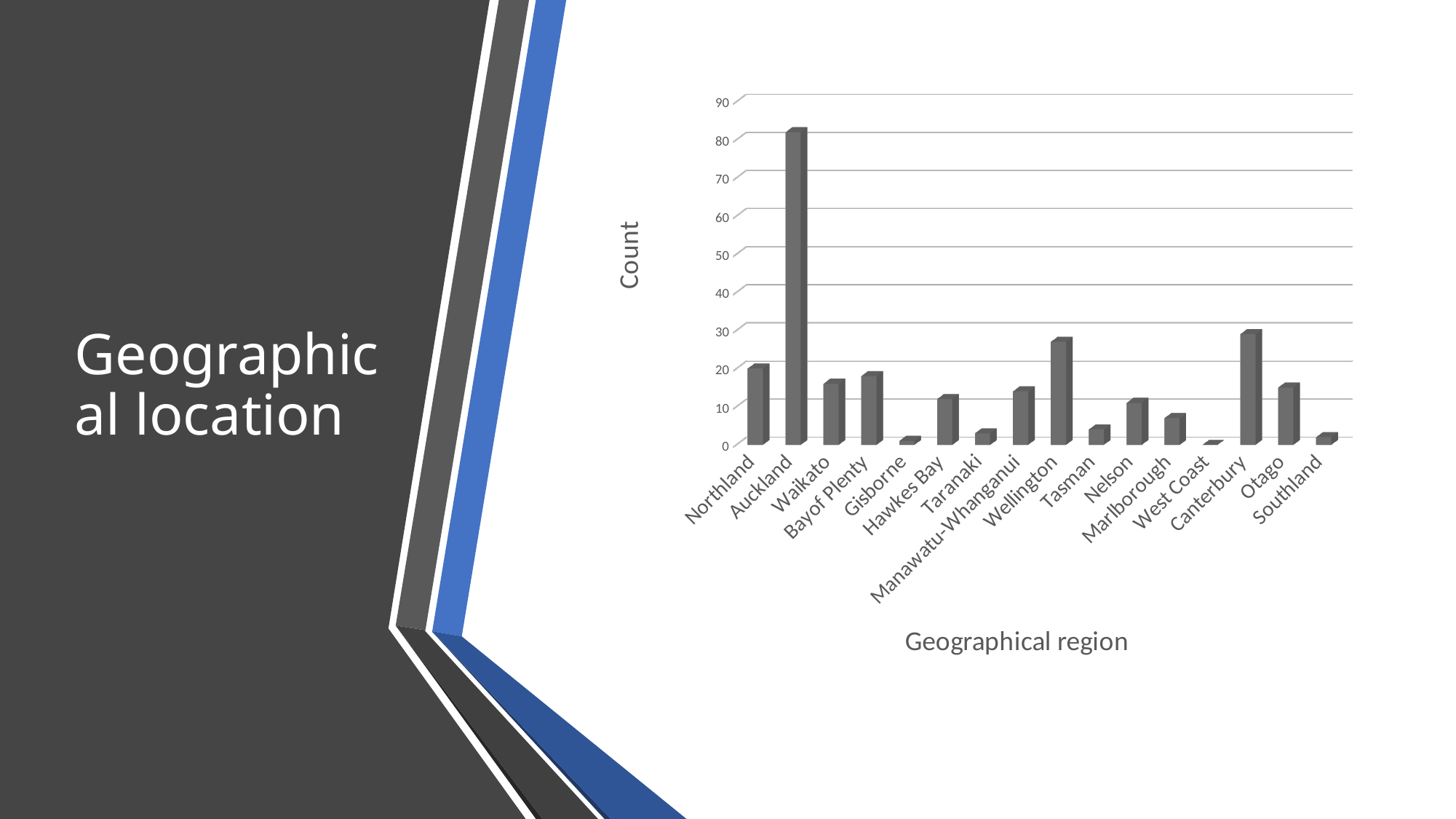
What is the title of the vertical axis of the chart? Count Which has a higher count, Auckland or Canterbury? Auckland Is the count for Gisborne greater or less than 10? less Which geographical region has the lowest count? West Coast How many geographical regions are shown on the x axis of the chart? 16 Which has a higher count, Wellington or Northland? Wellington What kind of chart is shown on the slide? Bar chart Which geographical region has the highest count? Auckland What is the title of the horizontal axis of the chart? Geographical region Is the count for Northland greater or less than 30? less Is the count for Auckland greater or less than 70? greater